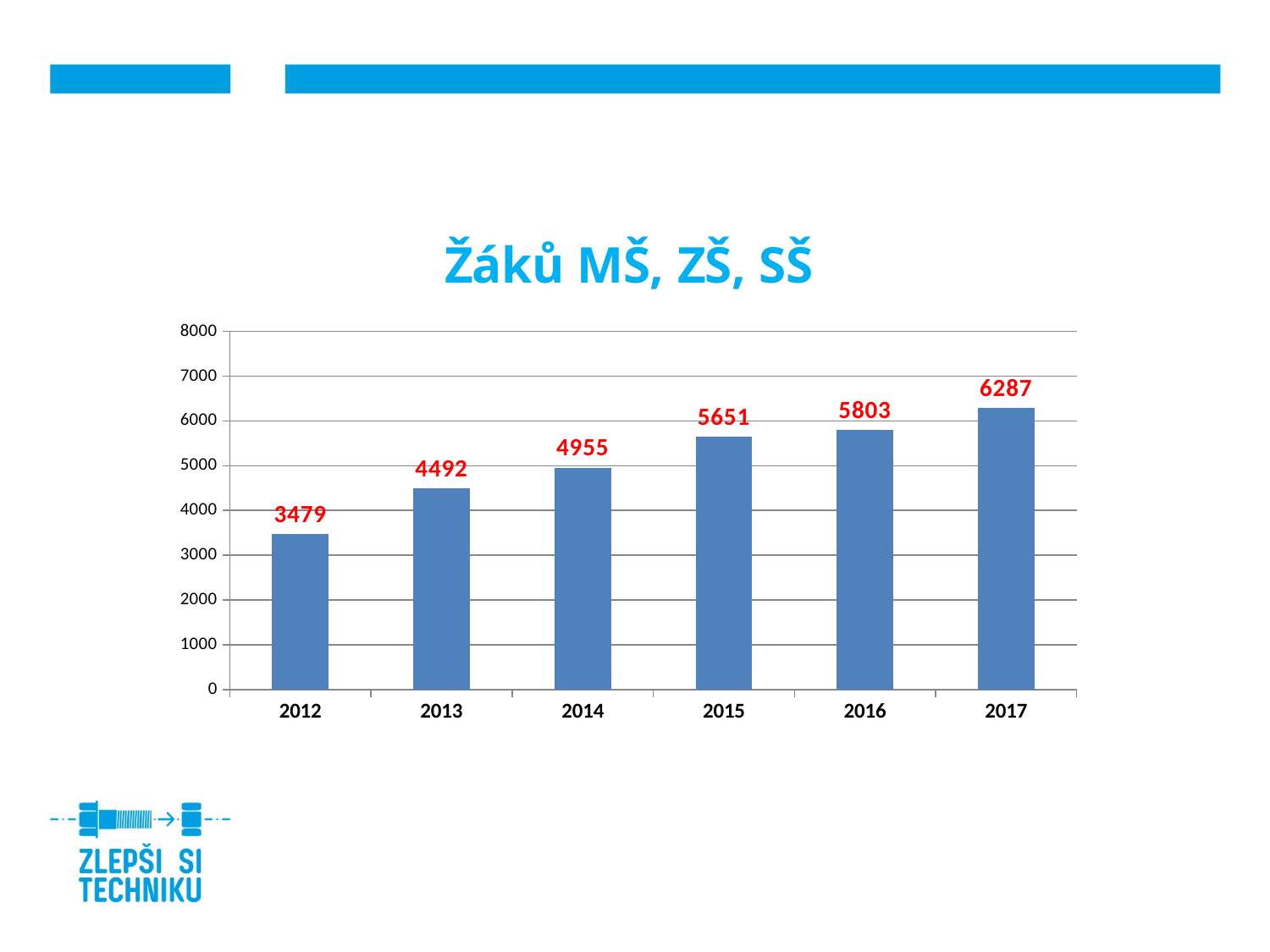
Do the values rise or fall from 2012 to 2017? rise Which is larger, the value for 2014 or the value for 2015? 2015 Which year has the highest value? 2017 What is the value for 2017? 6287 What is the value for 2012? 3479 Which year has the lowest value? 2012 How many years are shown on the x axis? 6 What is the difference between the values for 2013 and 2012? 1013 What is the difference between the values for 2017 and 2016? 484 What kind of chart is shown? bar chart What is the value for 2015? 5651 Is the value for 2016 greater or less than 5000? greater